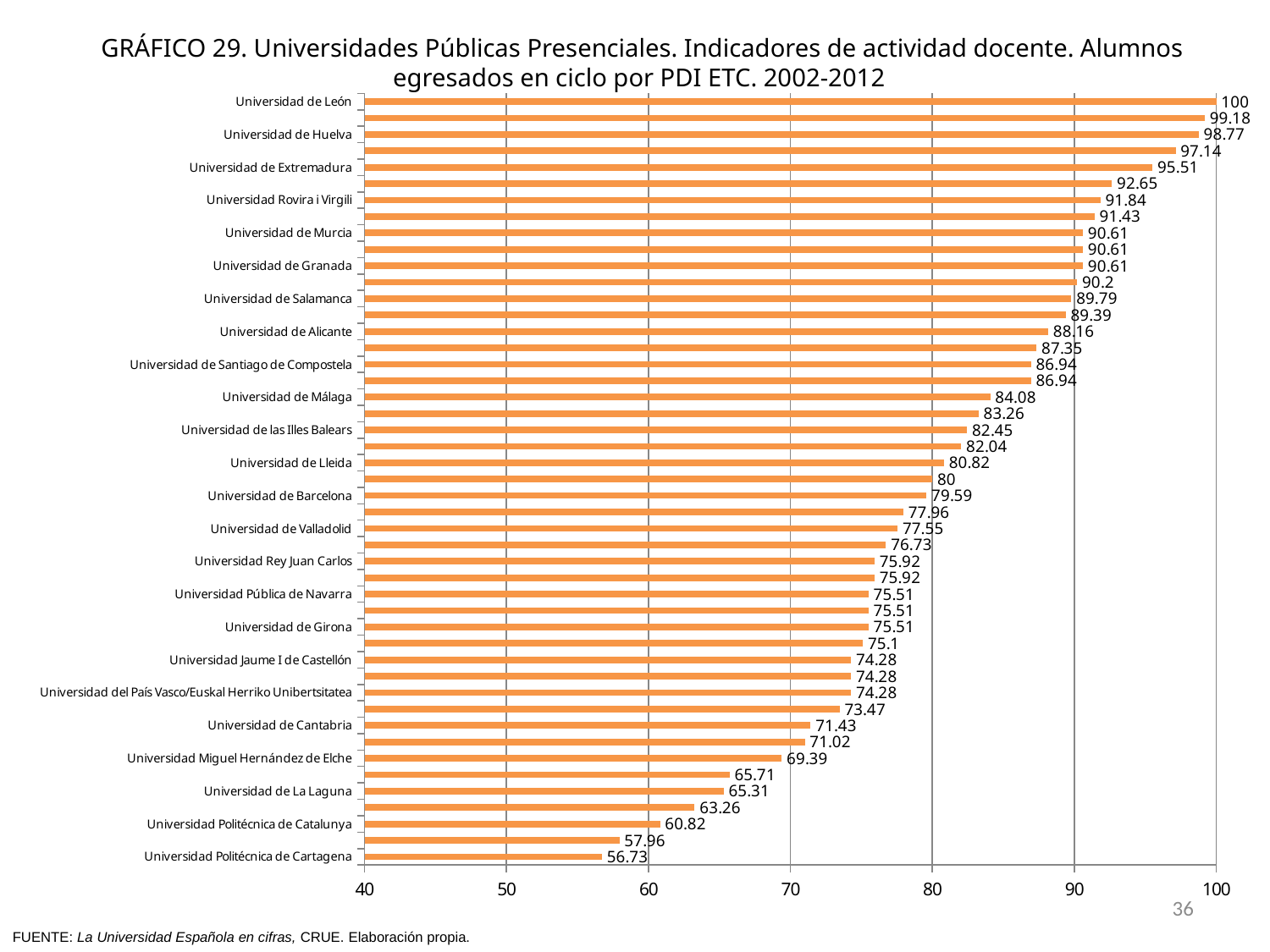
What kind of chart is shown on the slide? Bar chart What is the value for Universidad de Huelva? 98.77 What is the difference between the values for Universidad de León and Universidad Politécnica de Cartagena? 43.27 What is the value for Universidad de Salamanca? 89.79 Is the value for Universidad de Cantabria greater or less than 70? greater What is the value for Universidad de León? 100 What is the value for Universidad de La Laguna? 65.31 Do the values rise or fall going from the top bar to the bottom bar? Fall Which university has the lowest value? Universidad Politécnica de Cartagena Which university has the highest value? Universidad de León What is the value for Universidad Politécnica de Cartagena? 56.73 Which is larger, the value for Universidad de Málaga or the value for Universidad de Barcelona? Universidad de Málaga